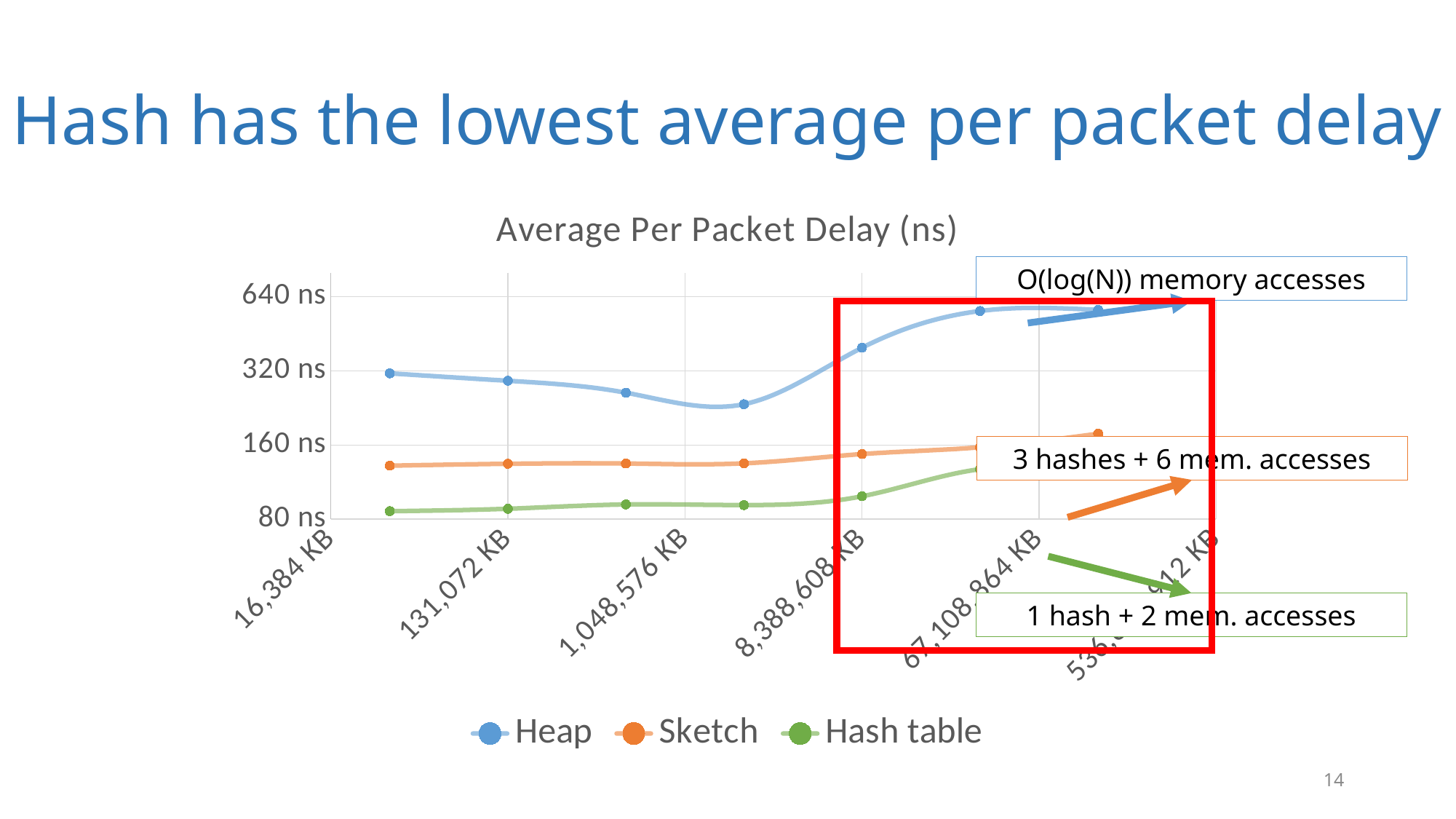
Does the Hash table line rise or fall as memory size increases along the x axis? rises What kind of chart is shown on the slide? line chart Is the leftmost value on the Hash table line greater or less than 160 ns? less Which series has the highest average per packet delay across the chart? Heap At the leftmost data point, which is larger: the Sketch value or the Hash table value? Sketch Which series has the lowest average per packet delay across the chart? Hash table What is the title of the chart? Average Per Packet Delay (ns) How many series does the legend list? 3 Is the leftmost value on the Heap line greater or less than 160 ns? greater Is the highest value on the Heap line greater or less than 640 ns? less How many memory-size labels are shown on the x axis? 6 What colour is used for the Sketch series? orange